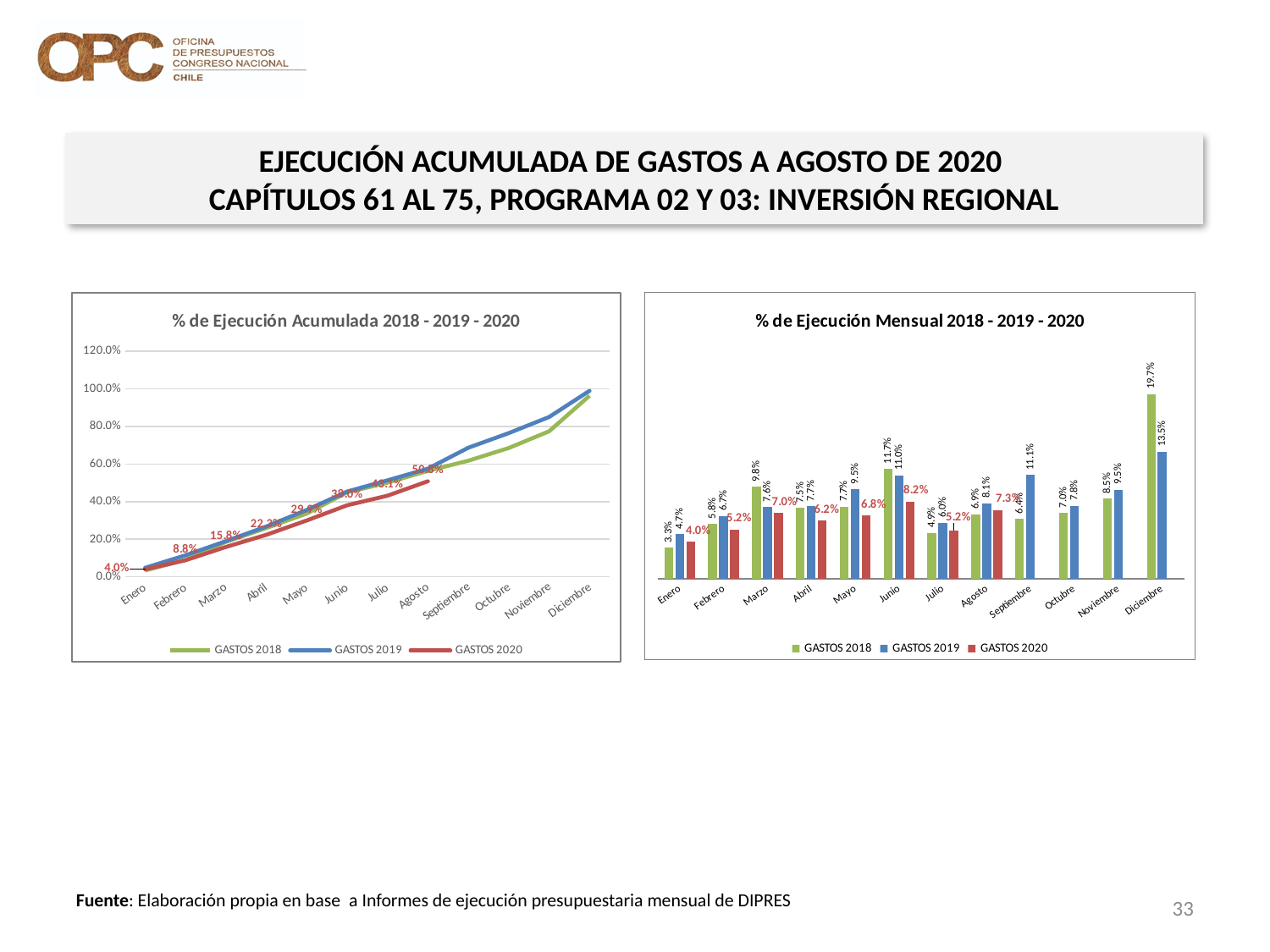
In the '% de Ejecución Mensual 2018 - 2019 - 2020' chart, which month has the highest value for GASTOS 2018? Diciembre In the '% de Ejecución Acumulada 2018 - 2019 - 2020' chart, do the GASTOS 2019 values rise or fall from Enero to Diciembre? Rise What kind of chart is the '% de Ejecución Mensual 2018 - 2019 - 2020' chart? Bar chart In the '% de Ejecución Mensual 2018 - 2019 - 2020' chart, what is the value for GASTOS 2020 in Agosto? 7.3% In the '% de Ejecución Acumulada 2018 - 2019 - 2020' chart, how many months are shown on the x axis? 12 In the '% de Ejecución Mensual 2018 - 2019 - 2020' chart, which is larger in Marzo: GASTOS 2018 or GASTOS 2019? GASTOS 2018 In the '% de Ejecución Mensual 2018 - 2019 - 2020' chart, which month has the lowest value for GASTOS 2018? Enero In the '% de Ejecución Mensual 2018 - 2019 - 2020' chart, what is the value for GASTOS 2019 in Junio? 11.0% In the '% de Ejecución Mensual 2018 - 2019 - 2020' chart, what is the value for GASTOS 2018 in Diciembre? 19.7% In the '% de Ejecución Mensual 2018 - 2019 - 2020' chart, what is the difference between GASTOS 2018 and GASTOS 2019 in Diciembre? 6.2% In the '% de Ejecución Acumulada 2018 - 2019 - 2020' chart, what is the value for GASTOS 2020 in Febrero? 8.8% In the '% de Ejecución Mensual 2018 - 2019 - 2020' chart, how many series does the legend list? 3